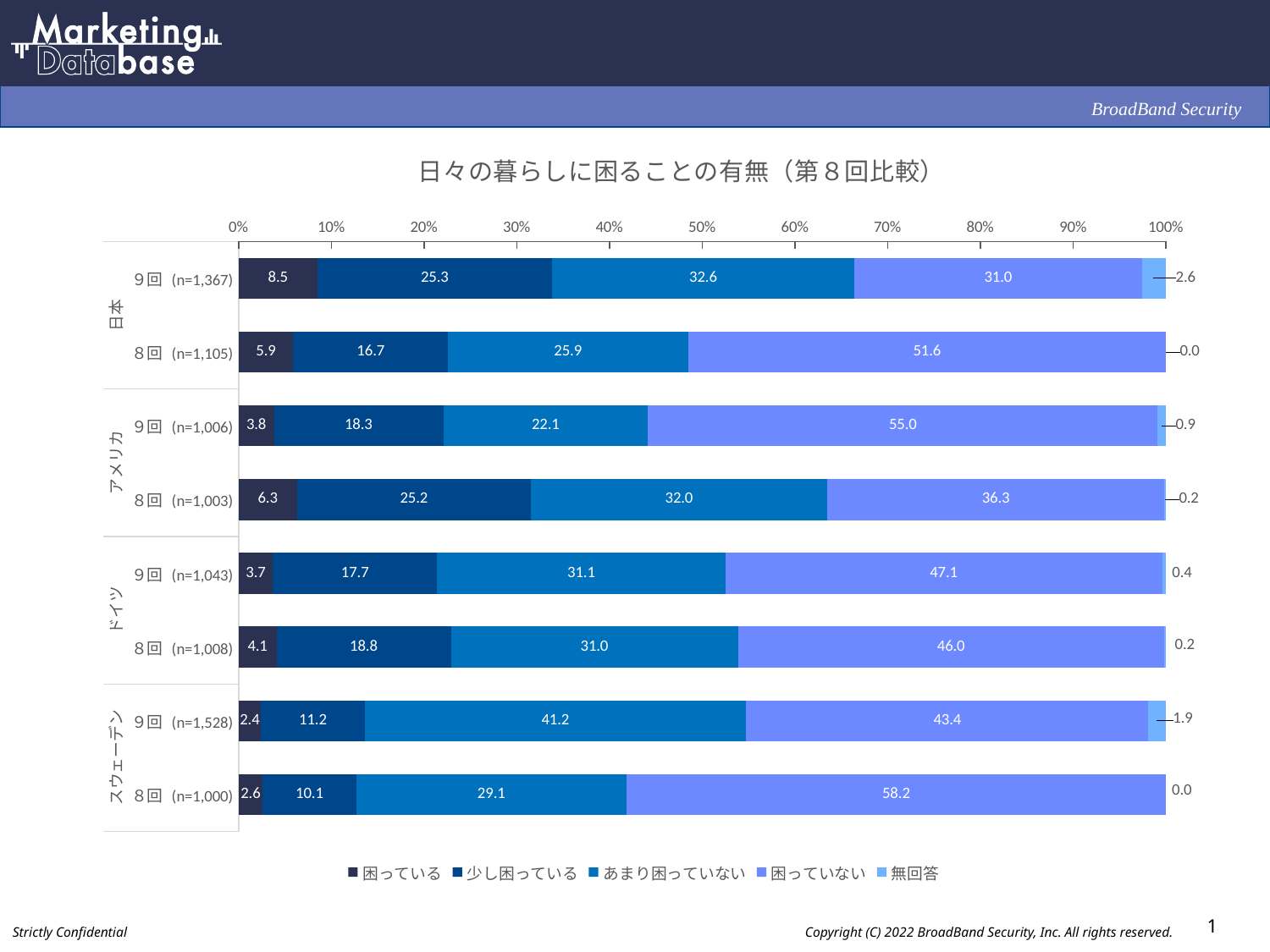
How many series does the legend list? 5 Which is larger: 少し困っている for アメリカ 8回 (n=1,003) or for アメリカ 9回 (n=1,006)? アメリカ 8回 (n=1,003) Which bar has the lowest value for 困っている? スウェーデン 9回 (n=1,528) What is the title of the chart? 日々の暮らしに困ることの有無（第８回比較） What is the value of 無回答 for 日本 9回 (n=1,367)? 2.6 What is the value of 困っていない for スウェーデン 8回 (n=1,000)? 58.2 What type of chart is shown on the slide? Stacked bar chart What is the difference in 困っていない between 日本 8回 (n=1,105) and 日本 9回 (n=1,367)? 20.6 What is the value of あまり困っていない for アメリカ 9回 (n=1,006)? 22.1 How many bars (survey rows) are plotted in the chart? 8 Which bar has the highest value for 困っていない? スウェーデン 8回 (n=1,000) What is the value of 困っている for 日本 9回 (n=1,367)? 8.5